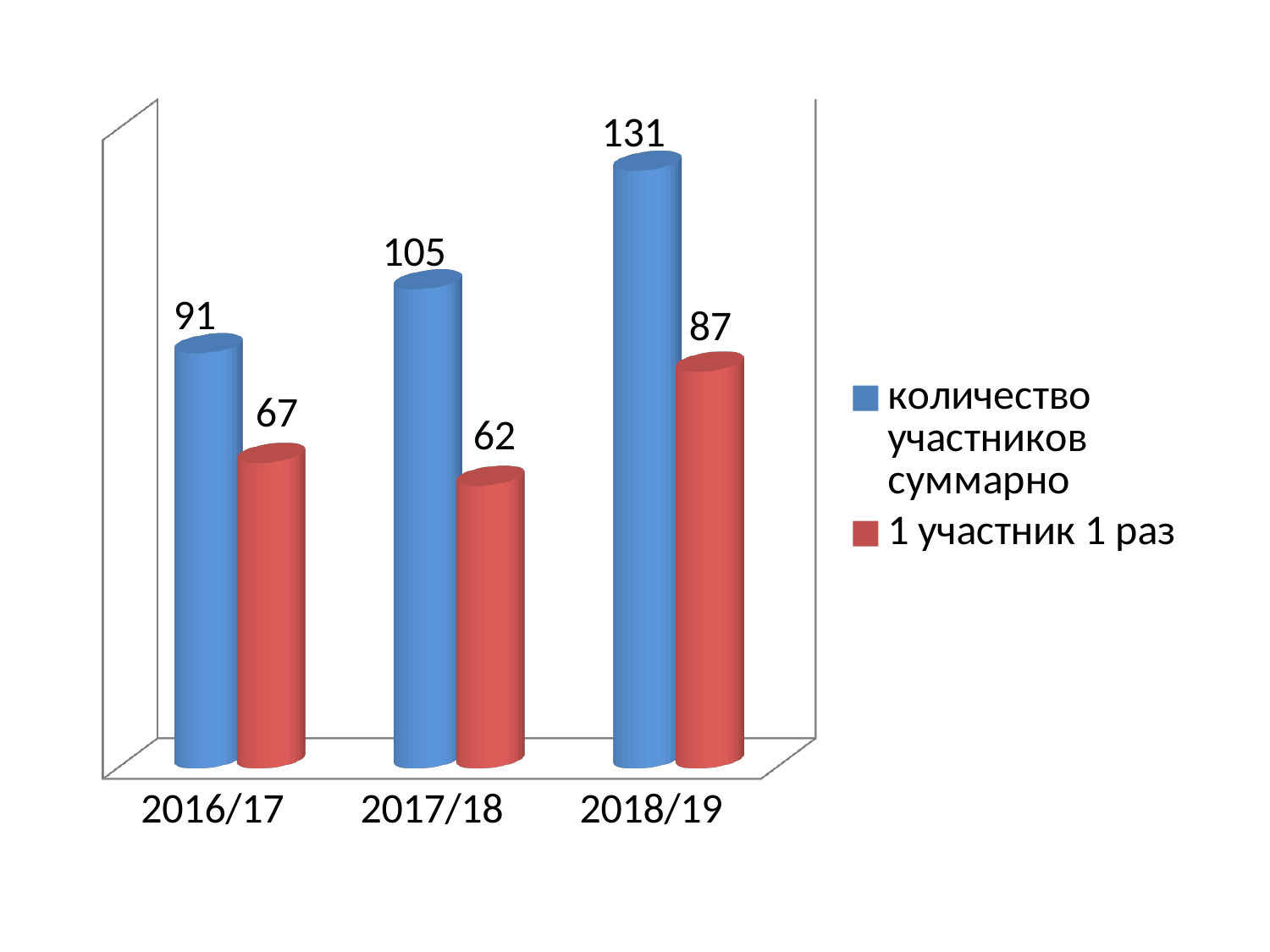
What is the value of 'количество участников суммарно' for 2017/18? 105 Which is larger: '1 участник 1 раз' in 2016/17 or in 2017/18? 2016/17 What is the difference between 'количество участников суммарно' and '1 участник 1 раз' in 2018/19? 44 By how much did 'количество участников суммарно' increase from 2016/17 to 2018/19? 40 What is the value of 'количество участников суммарно' for 2018/19? 131 What kind of chart is shown on the slide? Bar chart Does 'количество участников суммарно' rise or fall from 2016/17 to 2018/19? Rise How many years are shown on the x axis? 3 Which year has the highest value for 'количество участников суммарно'? 2018/19 What is the value of '1 участник 1 раз' for 2016/17? 67 How many series does the legend list? 2 Which year has the lowest value for '1 участник 1 раз'? 2017/18